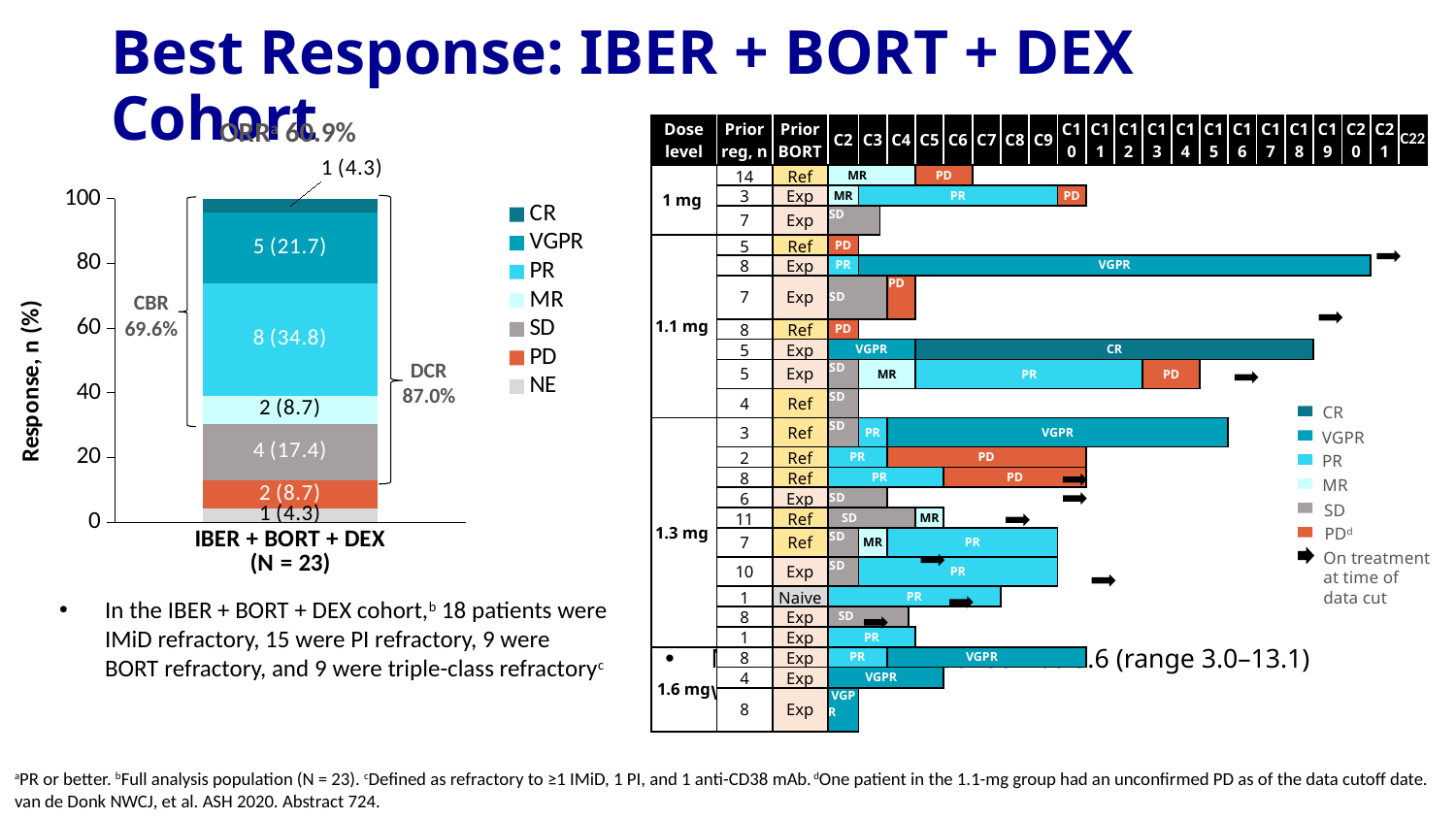
In the stacked bar chart, what is the value shown for the MR segment? 2 (8.7) What is the y-axis title of the stacked bar chart? Response, n (%) What is the total number of patients (n) across all segments of the IBER + BORT + DEX bar? 23 What DCR percentage is annotated next to the stacked bar chart? 87.0% In the stacked bar chart, what is the value shown for the PR segment of the IBER + BORT + DEX bar? 8 (34.8) How many series does the legend of the stacked bar chart list? 7 In the stacked bar chart, what is the value shown for the VGPR segment? 5 (21.7) What kind of chart is the chart on the left of the slide? Stacked bar chart In the stacked bar chart, what is the value shown for the SD segment? 4 (17.4) In the stacked bar chart, which response category has the largest segment? PR In the stacked bar chart, which segment is larger, VGPR or SD? VGPR In the stacked bar chart, how many more patients had PR than VGPR? 3